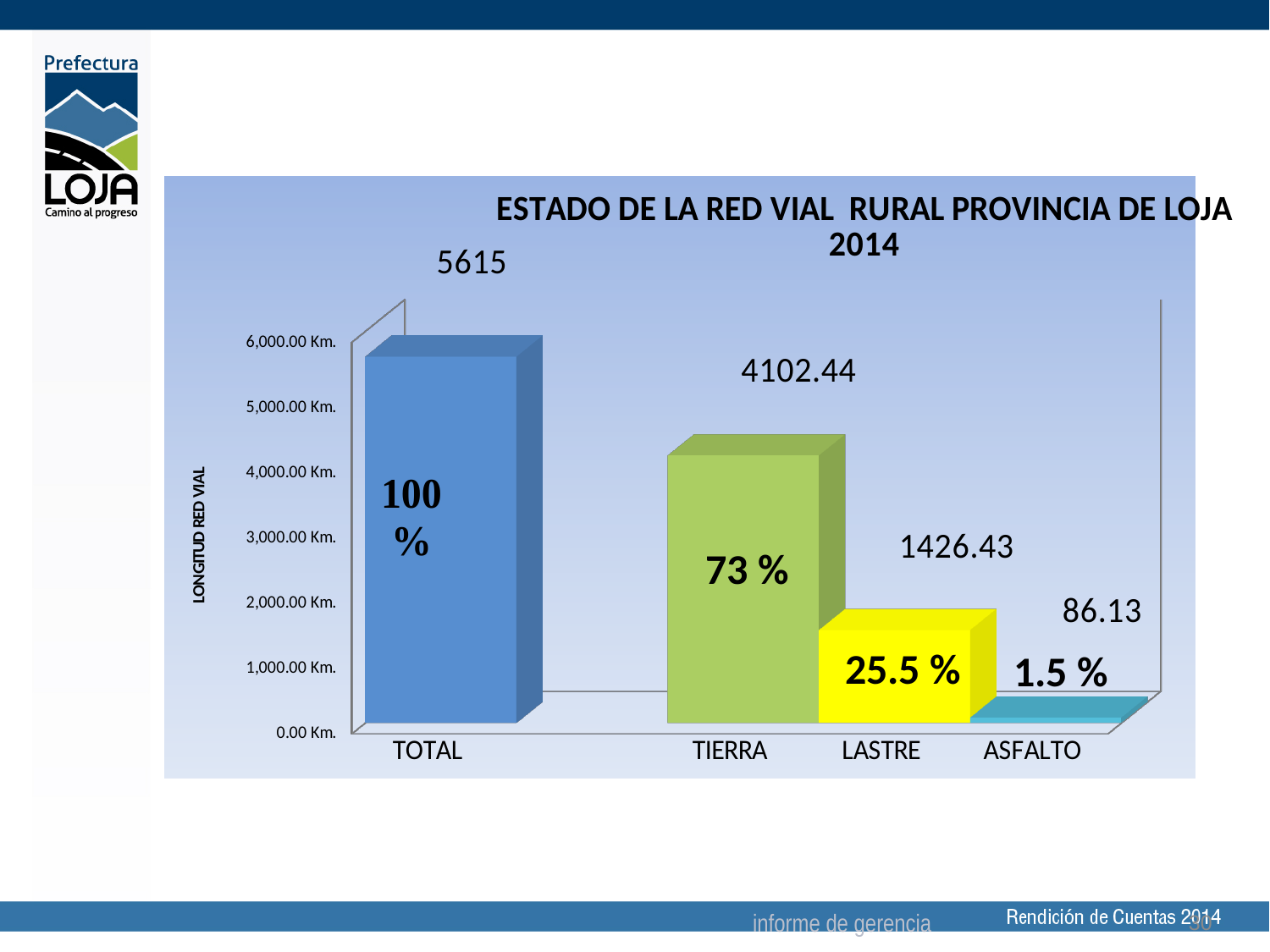
What percentage is shown on the LASTRE bar? 25.5 % What is the value for TIERRA? 4102.44 What is the difference between the TIERRA and LASTRE values? 2676.01 What is the value for ASFALTO? 86.13 Which category has the highest value? TOTAL What kind of chart is this? Bar chart How many categories are shown on the x axis? 4 What is the value for LASTRE? 1426.43 Which is larger, the value for LASTRE or the value for ASFALTO? LASTRE What is the label of the vertical axis? LONGITUD RED VIAL Which category has the lowest value? ASFALTO What percentage is shown on the TIERRA bar? 73 %